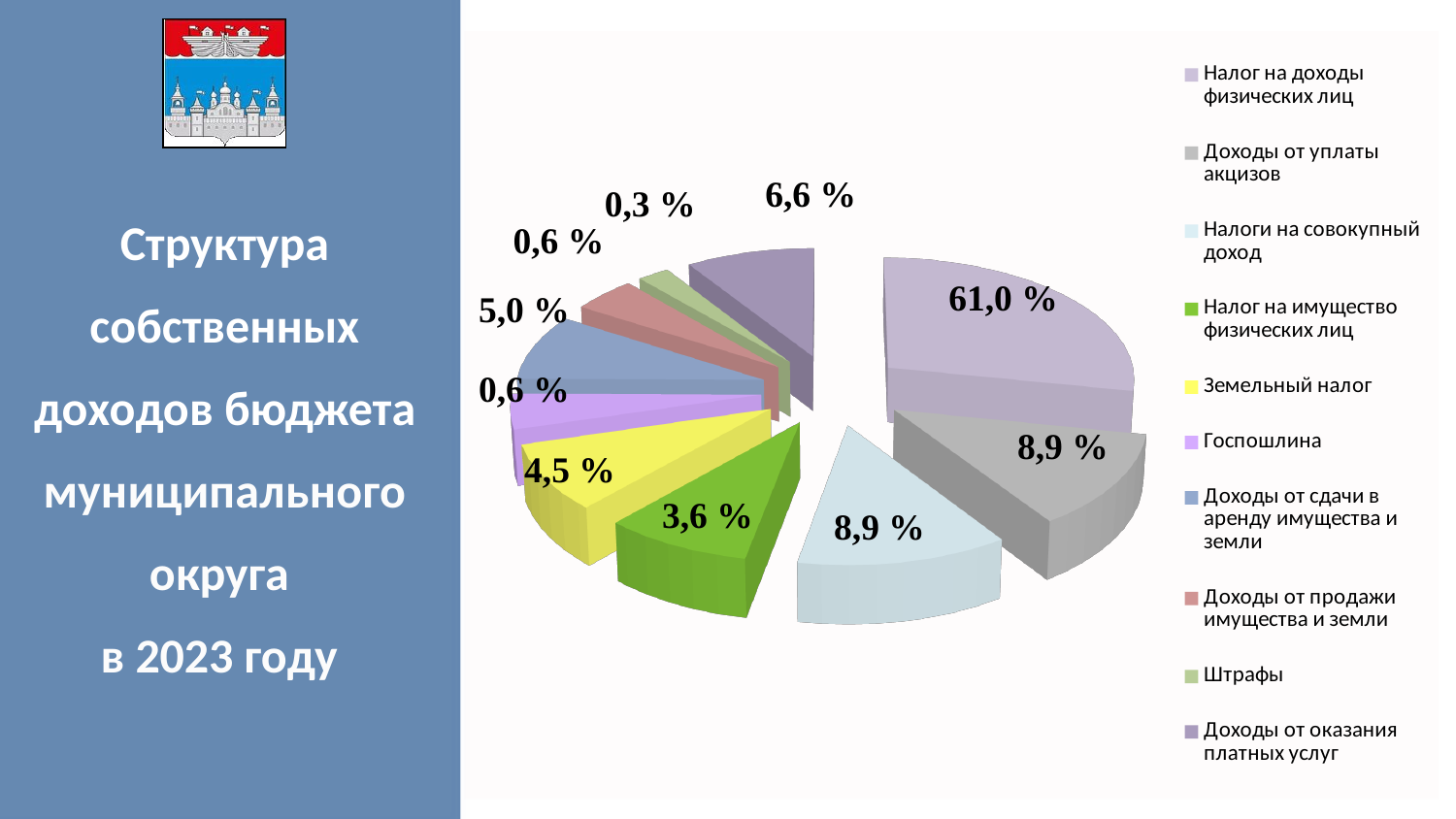
What share of the pie does "Налог на доходы физических лиц" have? 61,0 % Which is larger: the share of "Земельный налог" or the share of "Налог на имущество физических лиц"? Земельный налог What is the value shown for "Доходы от сдачи в аренду имущества и земли"? 5,0 % How many categories does the legend list? 10 What is the value shown for "Доходы от оказания платных услуг"? 6,6 % What is the title of the slide? Структура собственных доходов бюджета муниципального округа в 2023 году What kind of chart is shown on the slide? Pie chart What is the value shown for "Земельный налог"? 4,5 % What is the value shown for "Налог на имущество физических лиц"? 3,6 % Which category has the smallest share of the pie? Штрафы What is the difference between the shares of "Налог на доходы физических лиц" and "Доходы от уплаты акцизов"? 52,1 % Which category has the largest share of the pie? Налог на доходы физических лиц